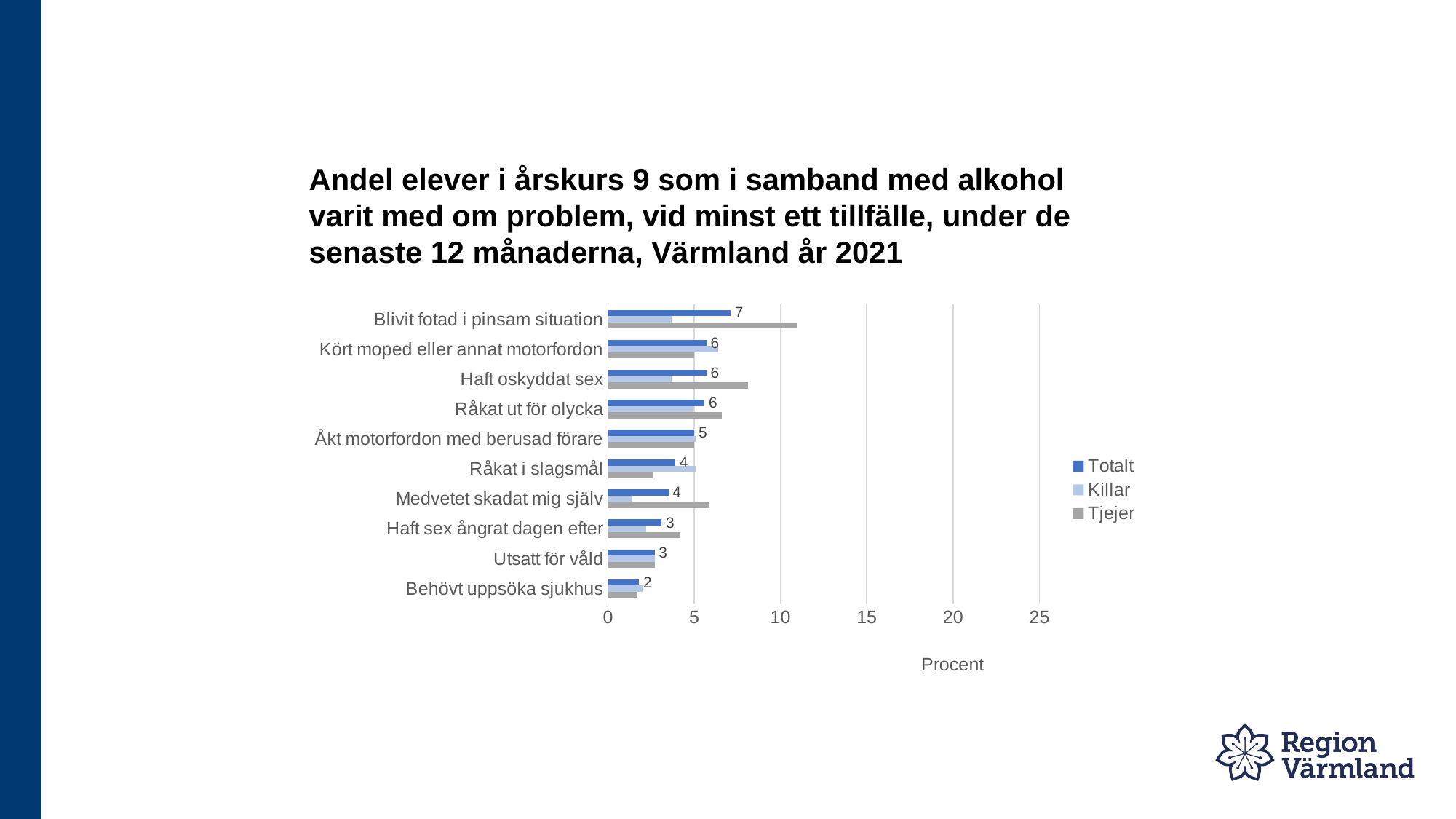
Is the Killar value for "Medvetet skadat mig själv" greater or less than 5? less How many series does the legend list? 3 Which category has the lowest Totalt value? Behövt uppsöka sjukhus What kind of chart is shown on the slide? Bar chart Which has the larger Totalt value, "Blivit fotad i pinsam situation" or "Råkat i slagsmål"? Blivit fotad i pinsam situation What is the Totalt value for "Behövt uppsöka sjukhus"? 2 What is the difference between the Totalt values for "Blivit fotad i pinsam situation" and "Behövt uppsöka sjukhus"? 5 What is the Totalt value for "Blivit fotad i pinsam situation"? 7 Is the Tjejer value for "Blivit fotad i pinsam situation" greater or less than 10? greater How many categories are shown on the chart? 10 What is the Totalt value for "Åkt motorfordon med berusad förare"? 5 Which category has the highest Totalt value? Blivit fotad i pinsam situation